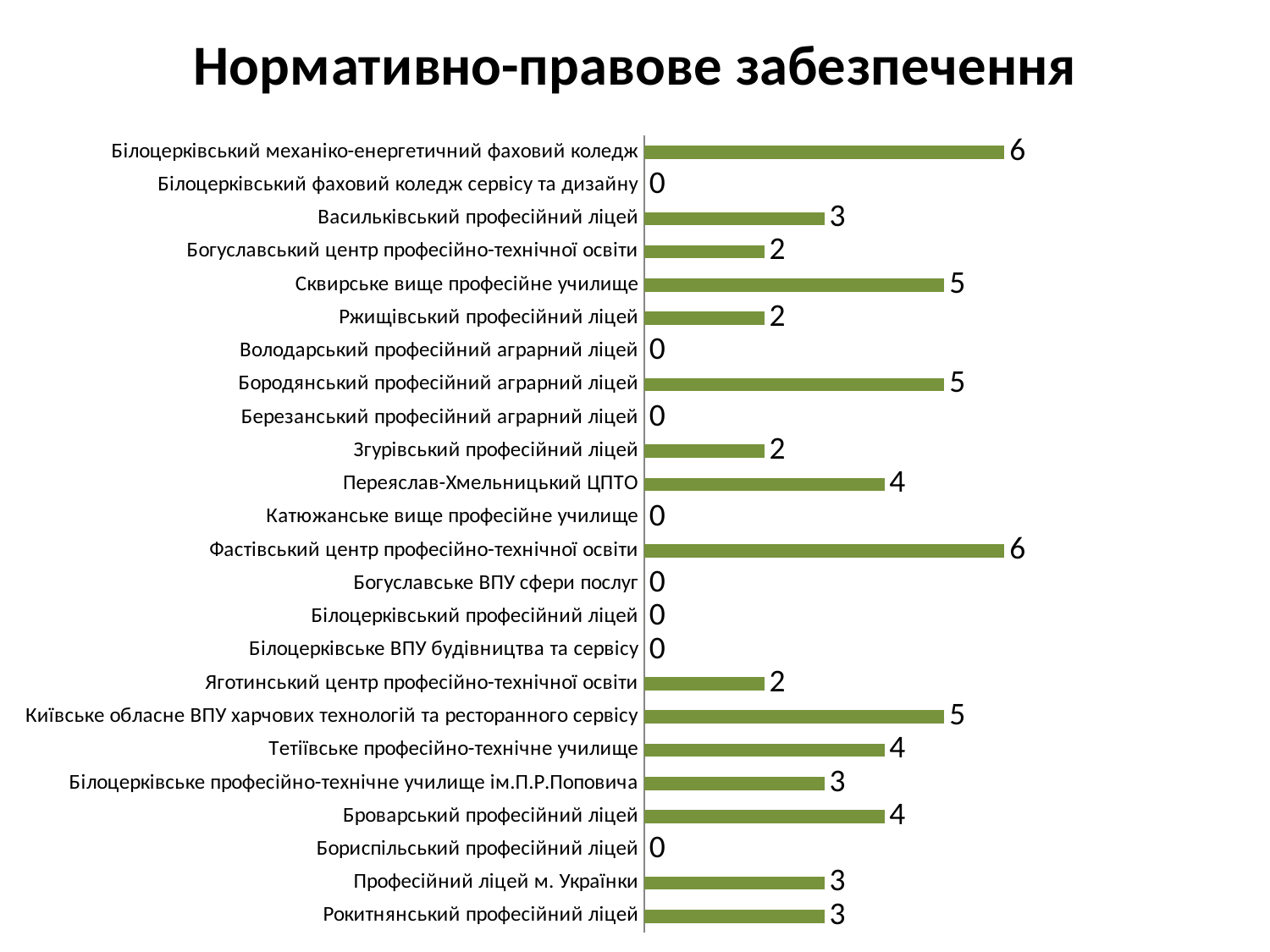
How many categories have a value of 0? 8 What is the highest value shown on the chart? 6 Which has a larger value: Броварський професійний ліцей or Рокитнянський професійний ліцей? Броварський професійний ліцей What type of chart is shown on the slide? Bar chart What is the difference between the values for Бородянський професійний аграрний ліцей and Васильківський професійний ліцей? 2 How many categories are shown on the chart? 24 What is the value for Бориспільський професійний ліцей? 0 What is the value for Переяслав-Хмельницький ЦПТО? 4 What is the value for Богуславський центр професійно-технічної освіти? 2 What is the value for Сквирське вище професійне училище? 5 What is the difference between the values for Фастівський центр професійно-технічної освіти and Яготинський центр професійно-технічної освіти? 4 Which has a larger value: Ржищівський професійний ліцей or Тетіївське професійно-технічне училище? Тетіївське професійно-технічне училище